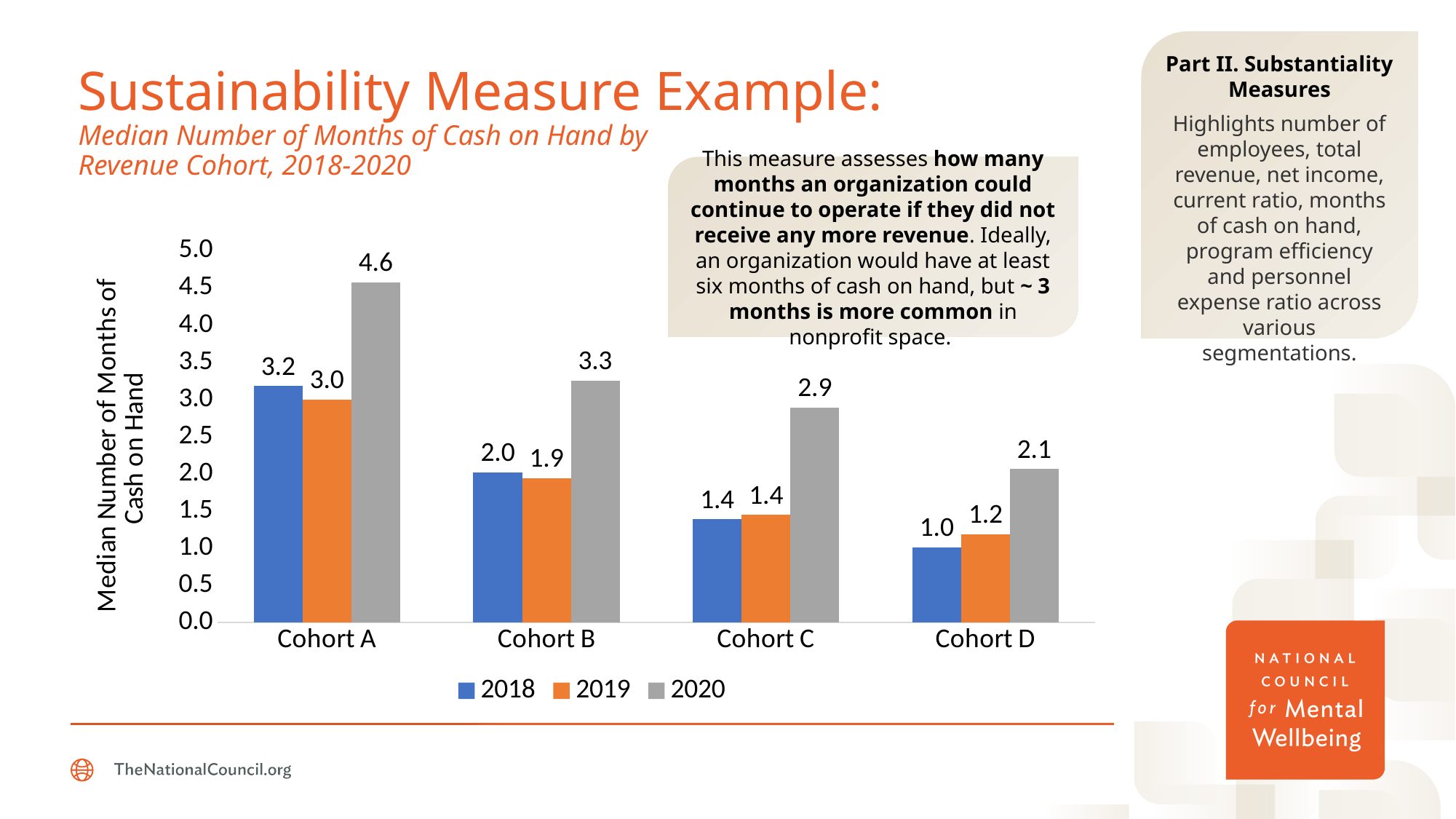
What is the value for Cohort D in 2018? 1.0 What is the value for Cohort B in 2019? 1.9 What kind of chart is shown on the slide? Bar chart How many series does the legend list? 3 How many cohorts are shown on the x axis? 4 What is the label of the y axis? Median Number of Months of Cash on Hand Which cohort has the highest value in 2020? Cohort A Which is larger: the 2019 value for Cohort A or the 2020 value for Cohort B? 2020 value for Cohort B Do the 2020 values rise or fall from Cohort A to Cohort D? Fall Which cohort has the lowest value in 2018? Cohort D What is the difference between the 2020 and 2018 values for Cohort C? 1.5 What is the median number of months of cash on hand for Cohort A in 2020? 4.6